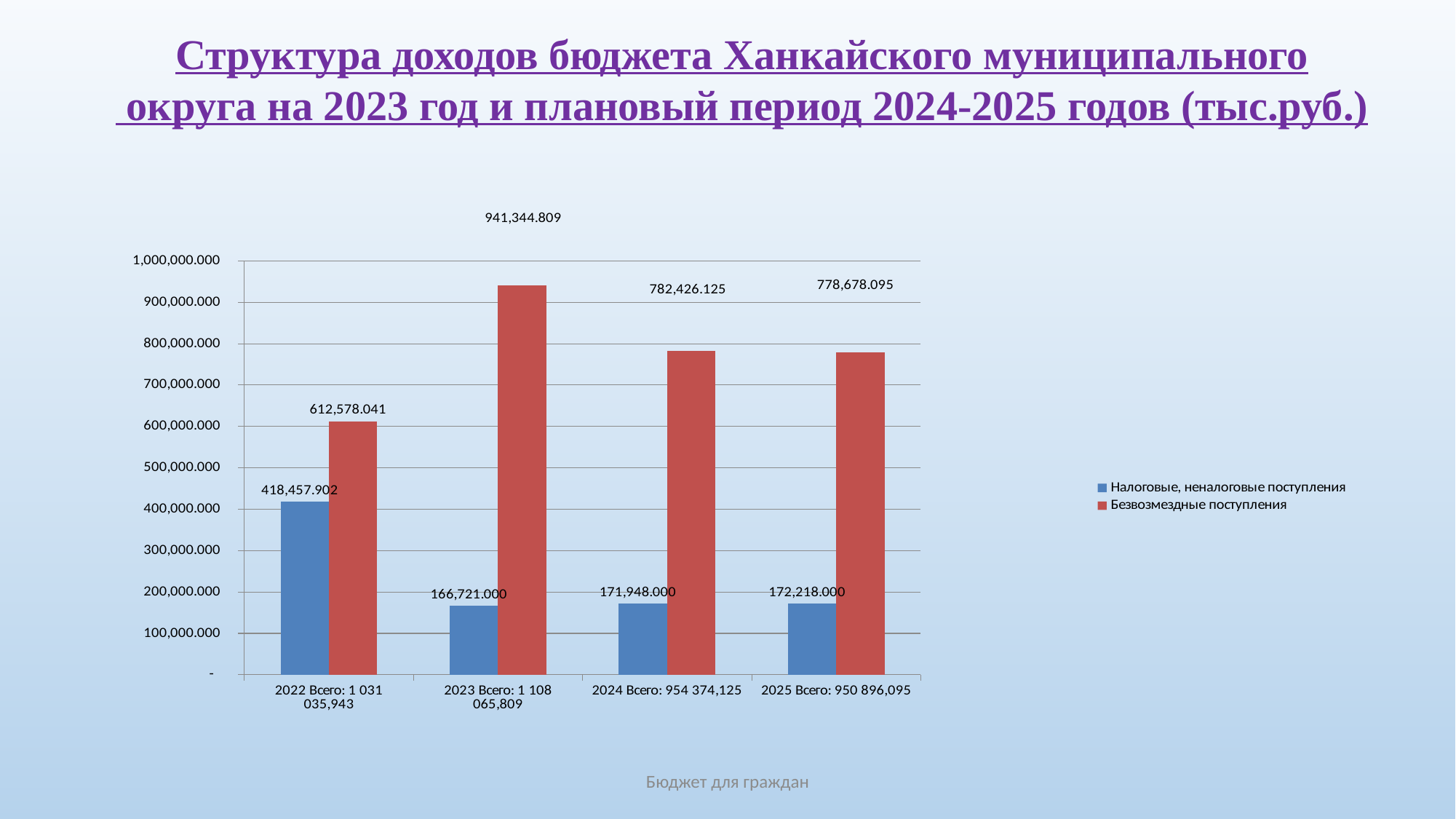
How many series does the legend list? 2 What is the value of Безвозмездные поступления for 2023? 941,344.809 In which year is Безвозмездные поступления highest? 2023 What is the difference between Безвозмездные поступления and Налоговые, неналоговые поступления in 2022? 194,120.139 What is the value of Безвозмездные поступления for 2025? 778,678.095 What kind of chart is shown on the slide? Bar chart Which is larger in 2022: Налоговые, неналоговые поступления or Безвозмездные поступления? Безвозмездные поступления In which year is Налоговые, неналоговые поступления lowest? 2023 What is the difference between Безвозмездные поступления in 2024 and in 2025? 3,748.030 What is the value of Налоговые, неналоговые поступления for 2024? 171,948.000 What is the value of Налоговые, неналоговые поступления for 2022? 418,457.902 How many years (categories) are shown on the x axis? 4